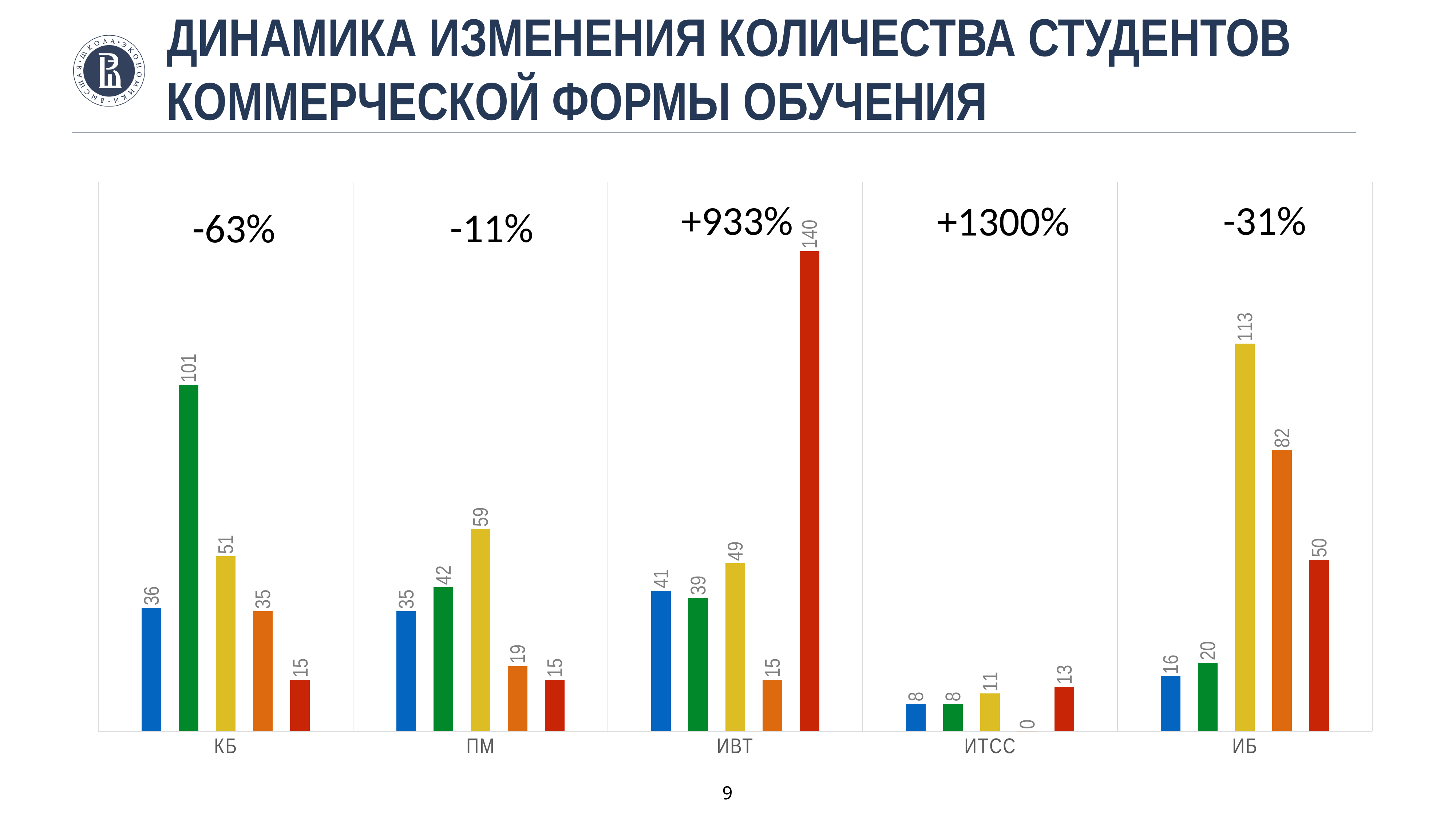
What is the difference between the yellow bar and the orange bar for ИБ? 31 Which is larger: the yellow bar for ПМ or the yellow bar for КБ? the yellow bar for ПМ What is the value of the yellow bar for ИБ? 113 What is the difference between the red bar for ИВТ and the red bar for ИБ? 90 What type of chart is shown on the slide? bar chart What percentage change is printed above the ИТСС group? +1300% What is the value of the orange bar for ИТСС? 0 Which category has the tallest bar in the chart? ИВТ What is the value of the green bar for КБ? 101 How many categories are shown along the x axis of the chart? 5 What is the value of the red bar for ИВТ? 140 What percentage change is printed above the КБ group? -63%